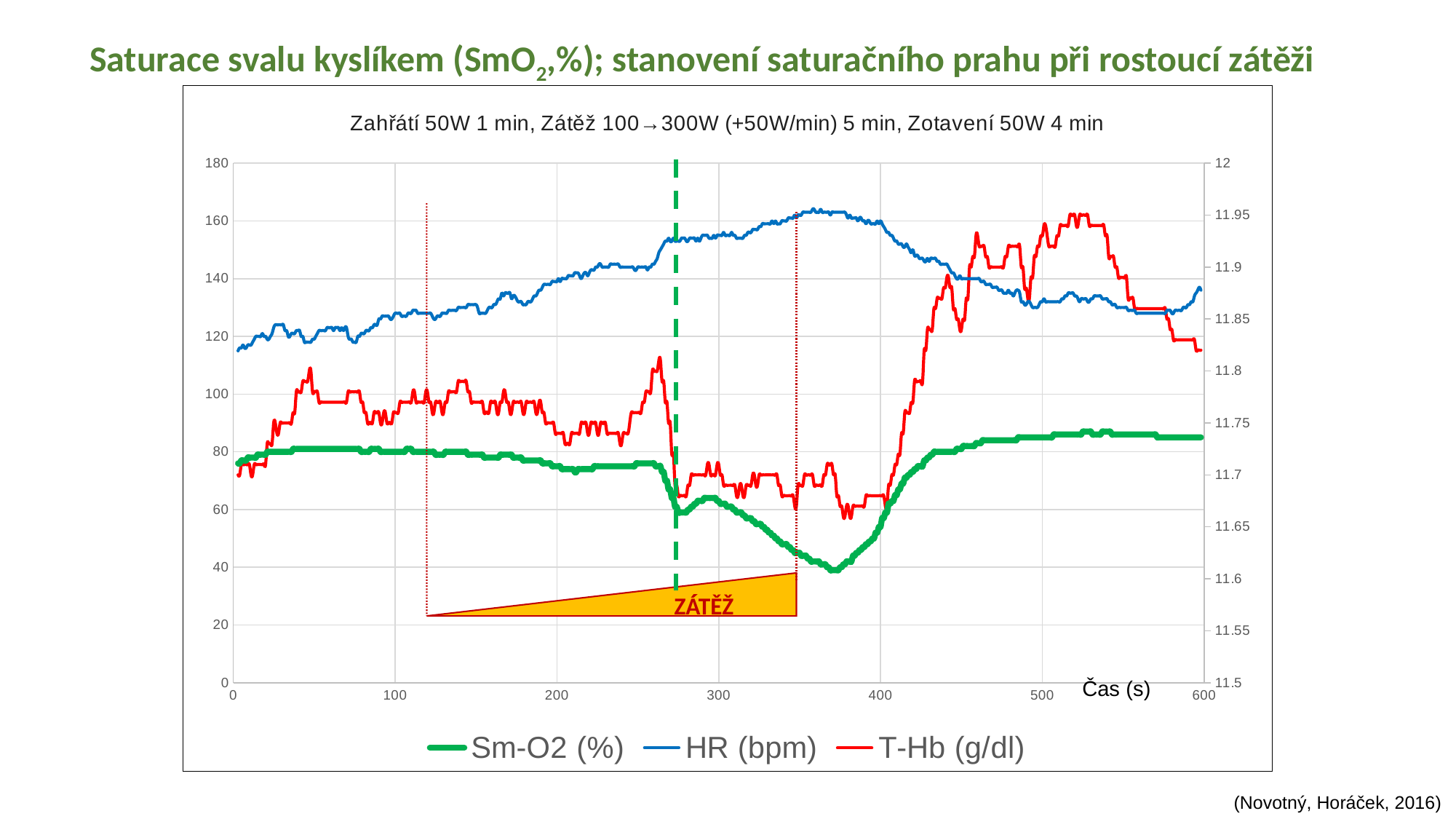
Is the value of HR (bpm) at 600 s greater or less than 120? greater Does HR (bpm) rise or fall between 0 s and 350 s? rise Is the value of HR (bpm) at time 0 s greater or less than 140? less What kind of chart is shown on the slide? line chart Is the value of Sm-O2 (%) at time 0 s greater or less than 60? greater How many series does the legend list? 3 Does Sm-O2 (%) rise or fall between 300 s and 370 s? fall Which is larger on the left axis: HR (bpm) at 350 s or HR (bpm) at 0 s? HR (bpm) at 350 s What is the label of the x axis? Čas (s) Which series is drawn in green according to the legend? Sm-O2 (%)